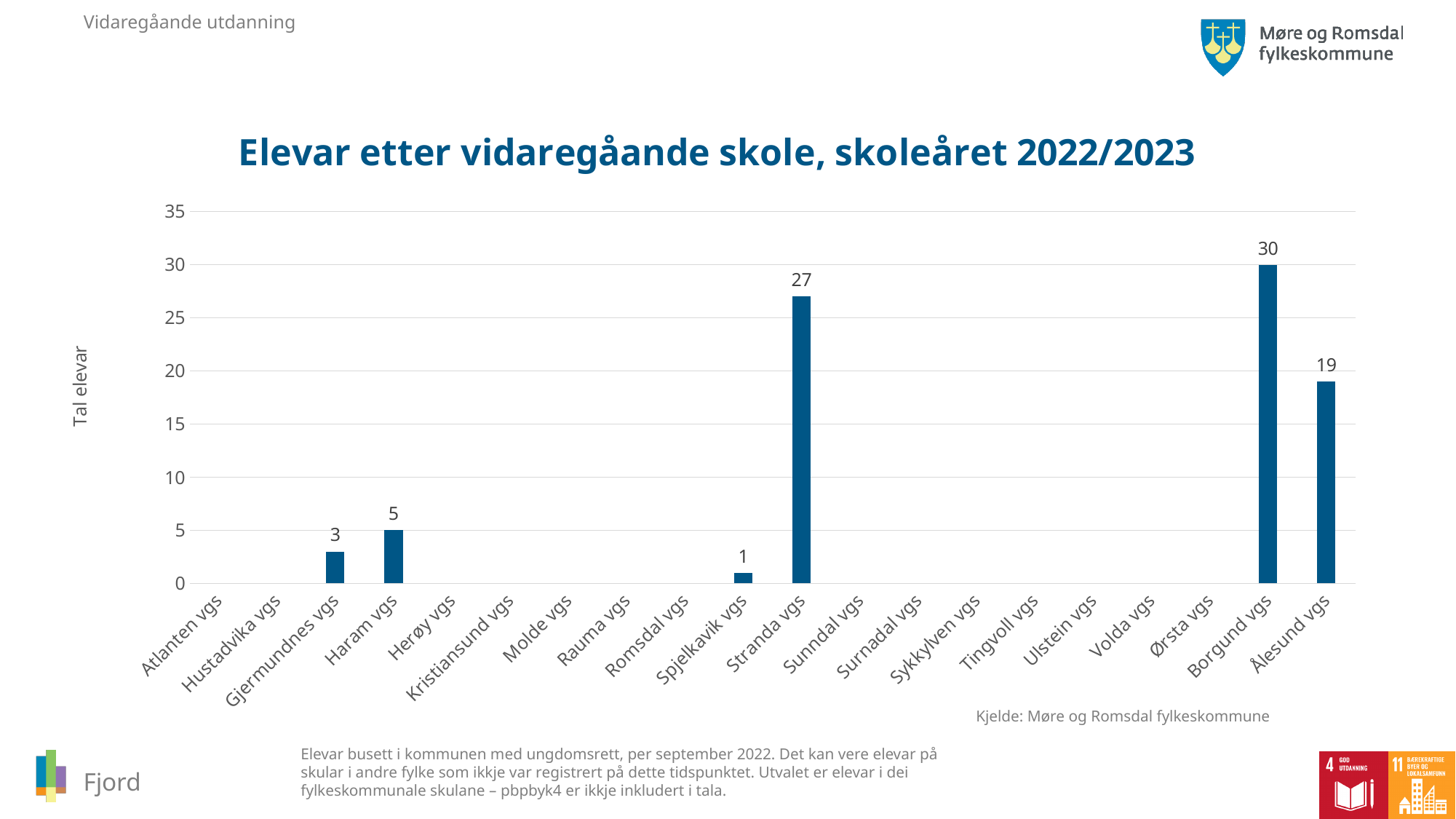
How many schools are listed on the x axis? 20 What is the value for Stranda vgs? 27 Which is larger, the value for Stranda vgs or the value for Ålesund vgs? Stranda vgs What is the difference between the values for Borgund vgs and Stranda vgs? 3 What is the difference between the values for Haram vgs and Gjermundnes vgs? 2 What is the value for Borgund vgs? 30 What is the value for Haram vgs? 5 Which school has the highest number of pupils? Borgund vgs What is the label of the y axis? Tal elevar What kind of chart is shown on the slide? Bar chart What is the value for Spjelkavik vgs? 1 What is the value for Ålesund vgs? 19